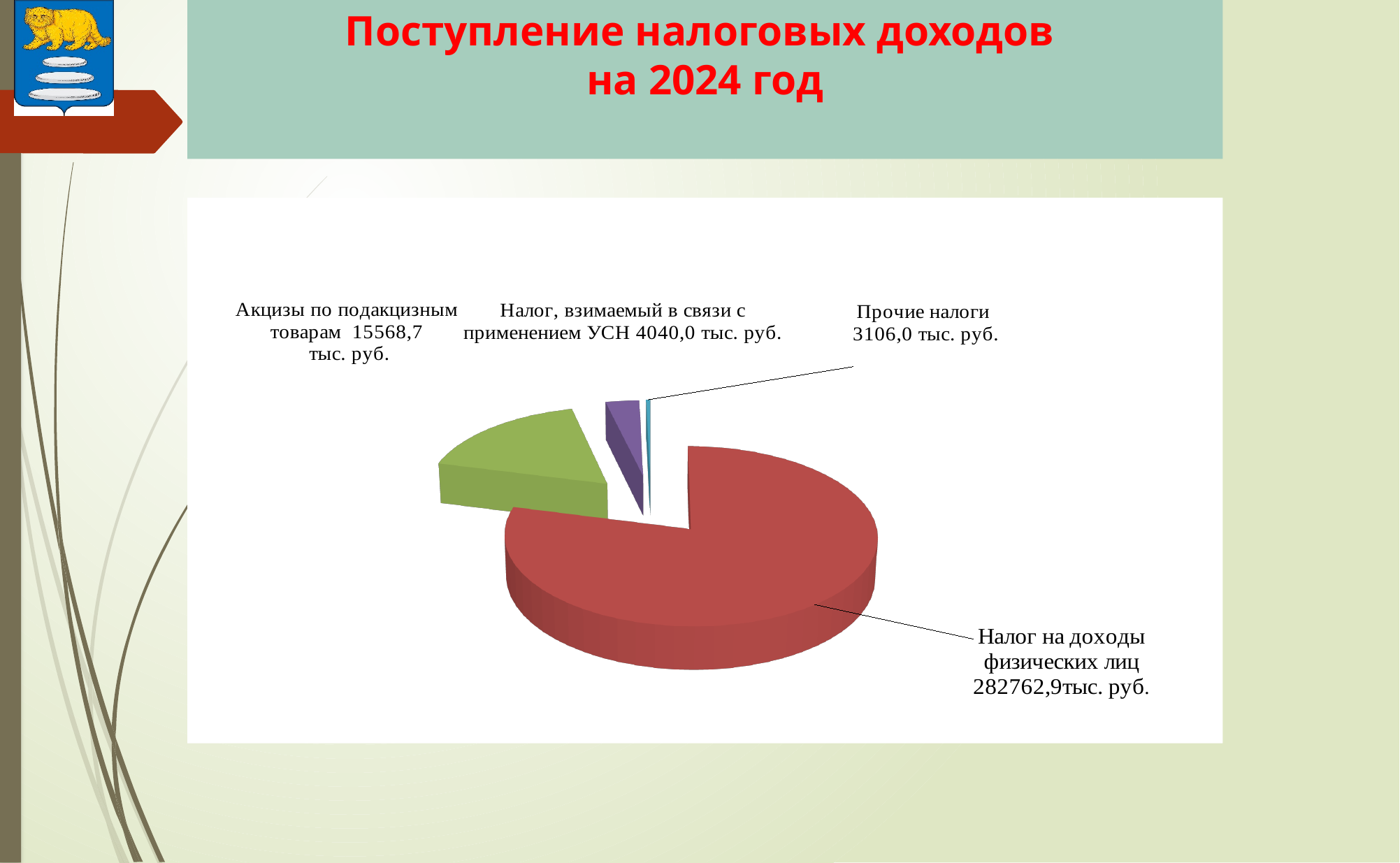
What is the value for Налог, взимаемый в связи с применением УСН? 4040,0 тыс. руб. Which category has the smallest slice of the pie? Прочие налоги What is the difference between Налог, взимаемый в связи с применением УСН and Прочие налоги? 934,0 тыс. руб. What is the value for Налог на доходы физических лиц? 282762,9 тыс. руб. What is the title of the slide? Поступление налоговых доходов на 2024 год Which category has the largest slice of the pie? Налог на доходы физических лиц Which is larger: Акцизы по подакцизным товарам or Налог, взимаемый в связи с применением УСН? Акцизы по подакцизным товарам What kind of chart is shown on the slide? Pie chart What is the value for Прочие налоги? 3106,0 тыс. руб. How many slices does the pie chart have? 4 What is the value for Акцизы по подакцизным товарам? 15568,7 тыс. руб. What is the difference between Налог на доходы физических лиц and Акцизы по подакцизным товарам? 267194,2 тыс. руб.